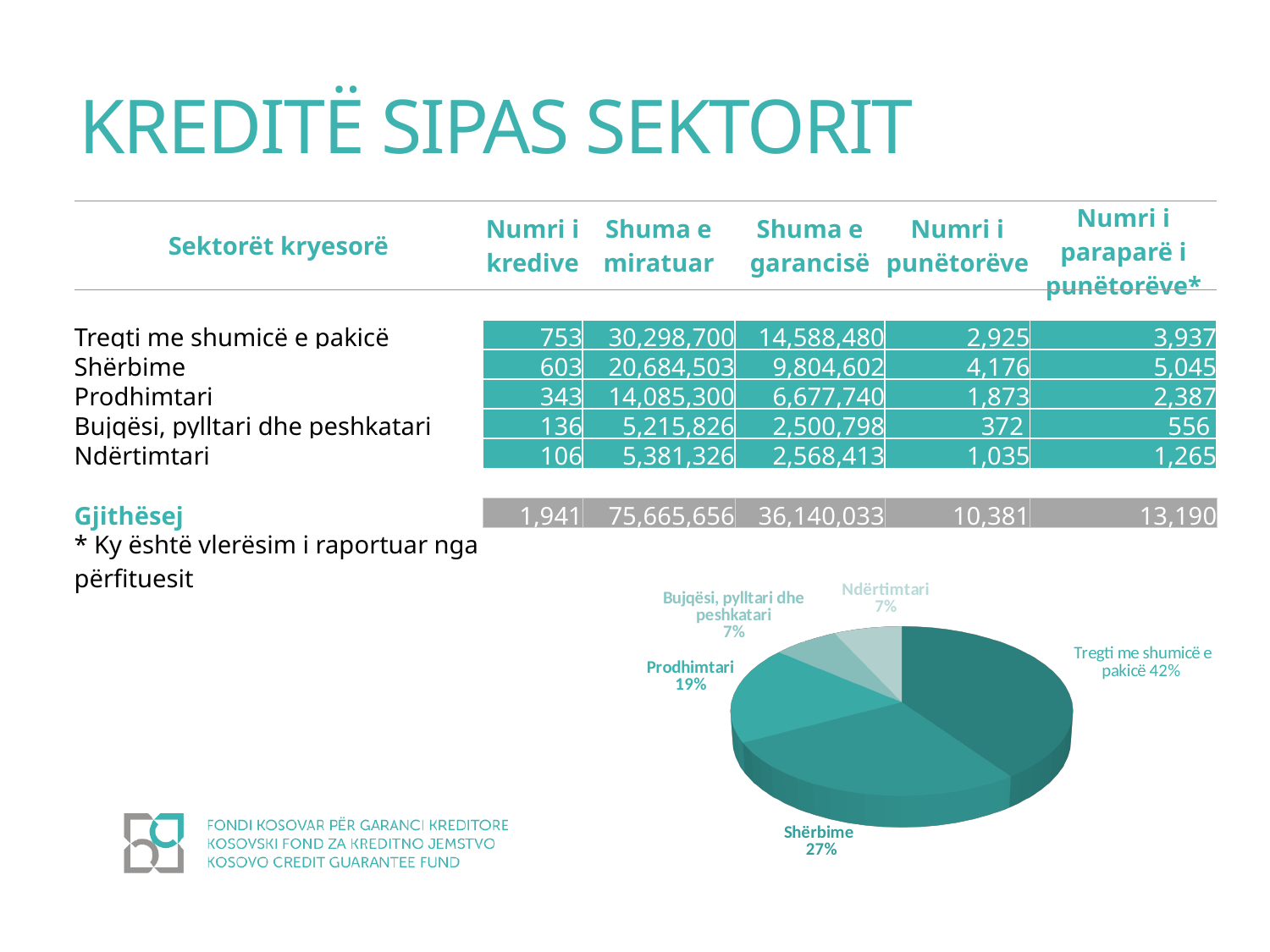
How many slices does the pie chart have? 5 In the pie chart, how many percentage points larger is Tregti me shumicë e pakicë than Shërbime? 15 percentage points What share of the pie chart does Tregti me shumicë e pakicë have? 42% Which two sectors share the smallest slice in the pie chart? Bujqësi, pylltari dhe peshkatari and Ndërtimtari What share of the pie chart does Shërbime have? 27% In the pie chart, what is the combined share of Bujqësi, pylltari dhe peshkatari and Ndërtimtari? 14% In the pie chart, which is larger: Shërbime or Prodhimtari? Shërbime What kind of chart is shown on the slide? Pie chart What share of the pie chart does Ndërtimtari have? 7% Which sector has the largest slice in the pie chart? Tregti me shumicë e pakicë